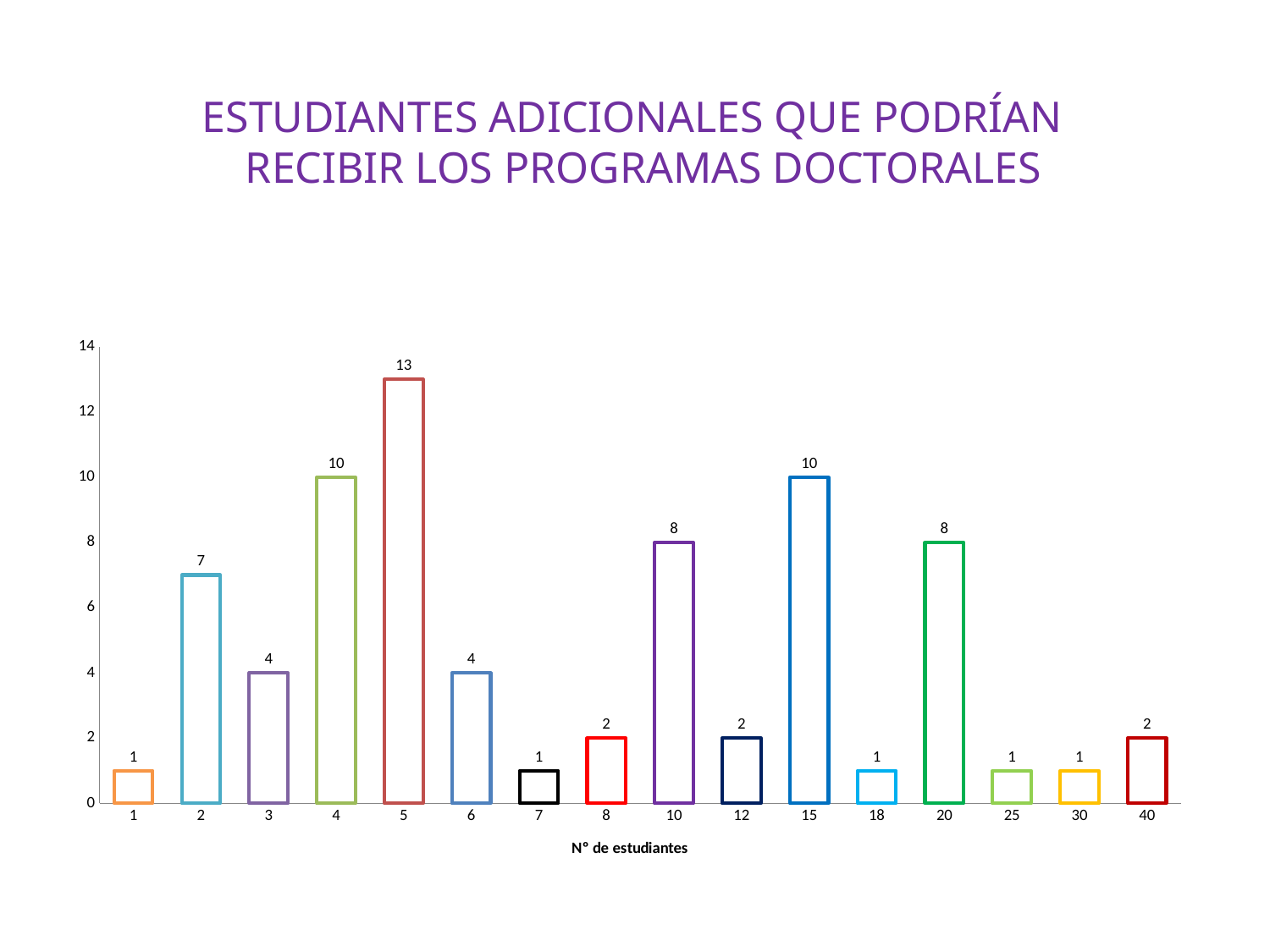
What is the value of the bar for category 5? 13 What is the difference between the values for category 5 and category 4? 3 How many categories are shown on the x axis? 16 What kind of chart is shown on the slide? bar chart What is the label of the x axis? N° de estudiantes What is the value of the bar for category 15? 10 Which category has the highest bar? 5 What is the difference between the values for category 2 and category 3? 3 What is the value of the bar for category 40? 2 Which is larger, the value for category 2 or the value for category 6? category 2 What is the title of the chart? ESTUDIANTES ADICIONALES QUE PODRÍAN RECIBIR LOS PROGRAMAS DOCTORALES Which is larger, the value for category 10 or the value for category 12? category 10